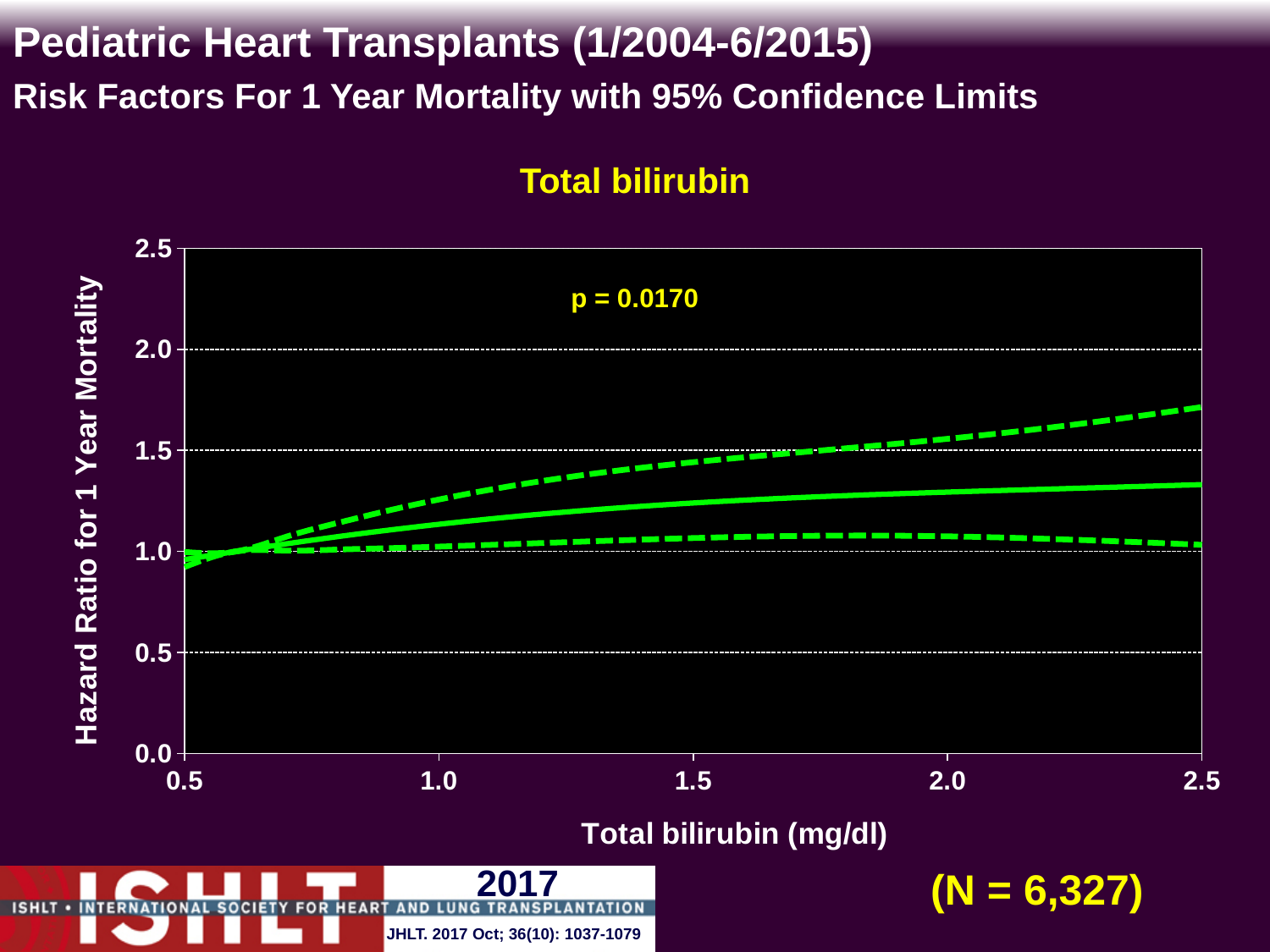
What kind of chart is shown on the slide? line chart Is the hazard ratio (solid line) at a total bilirubin of 2.5 mg/dl greater or less than 1.5? less Is the hazard ratio (solid line) at a total bilirubin of 2.5 mg/dl greater or less than 1.0? greater Does the hazard ratio for 1 year mortality rise or fall as total bilirubin increases from 0.5 to 2.5 mg/dl? rise Is the hazard ratio (solid line) at a total bilirubin of 1.0 mg/dl greater or less than 1.5? less What p-value is printed on the chart? p = 0.0170 What is the highest value shown on the y axis of the chart? 2.5 Which is larger at a total bilirubin of 2.5 mg/dl: the upper confidence limit or the solid hazard ratio line? the upper confidence limit What sample size (N) is shown on the slide? N = 6,327 How many lines are plotted on the chart? 3